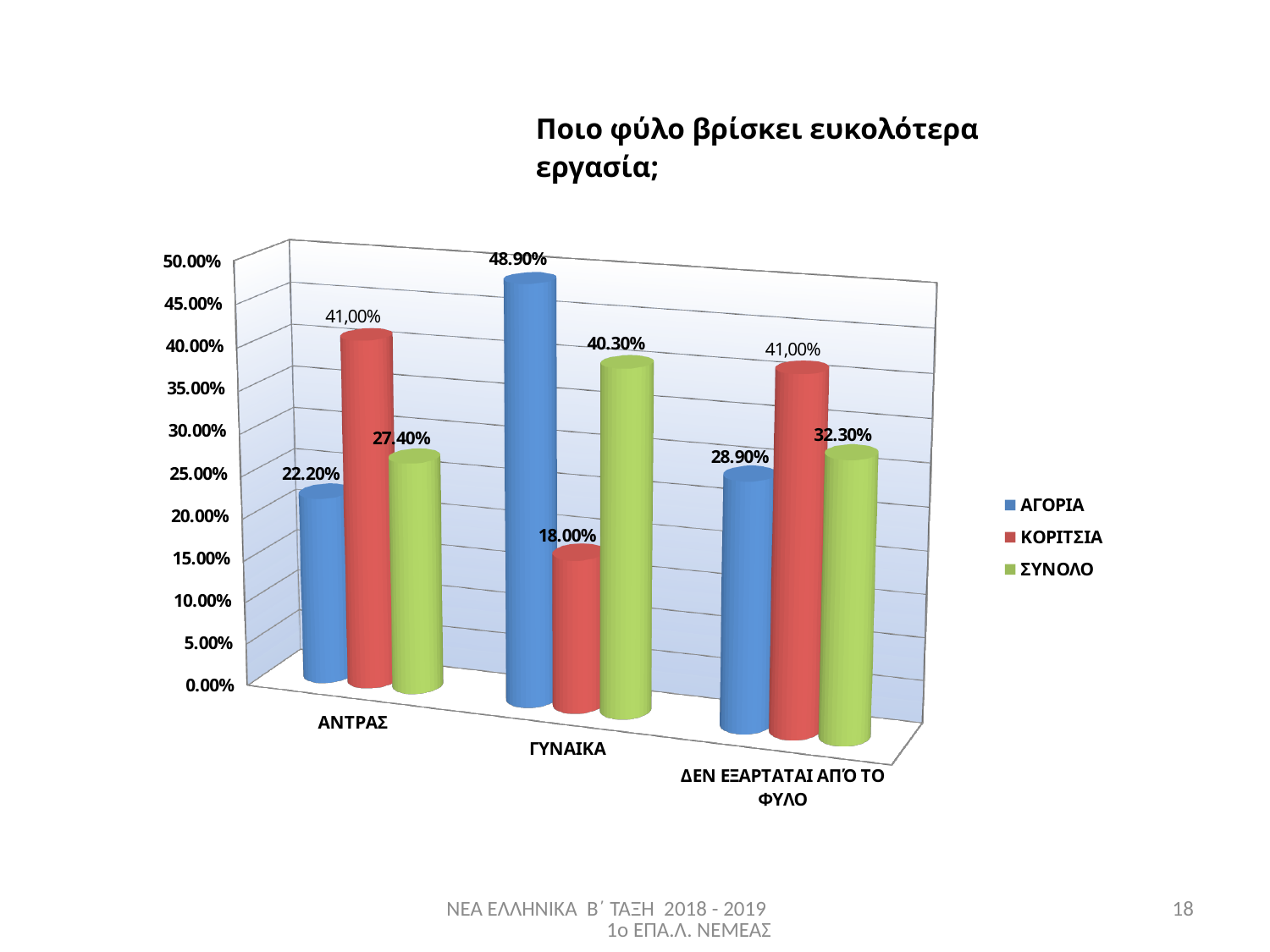
Which is larger in the ΔΕΝ ΕΞΑΡΤΑΤΑΙ ΑΠΌ ΤΟ ΦΥΛΟ category: ΑΓΟΡΙΑ or ΣΥΝΟΛΟ? ΣΥΝΟΛΟ How many series does the legend list? 3 What is the value for ΑΓΟΡΙΑ in the ΓΥΝΑΙΚΑ category? 48.90% What is the value for ΣΥΝΟΛΟ in the ΑΝΤΡΑΣ category? 27.40% What is the value for ΚΟΡΙΤΣΙΑ in the ΑΝΤΡΑΣ category? 41,00% In which category does the ΑΓΟΡΙΑ series have its highest value? ΓΥΝΑΙΚΑ What kind of chart is shown on the slide? Bar chart How many categories are shown on the x axis? 3 What is the value for ΣΥΝΟΛΟ in the ΔΕΝ ΕΞΑΡΤΑΤΑΙ ΑΠΌ ΤΟ ΦΥΛΟ category? 32.30% What is the difference between the ΑΓΟΡΙΑ values for ΓΥΝΑΙΚΑ and ΑΝΤΡΑΣ? 26.70% What is the value for ΚΟΡΙΤΣΙΑ in the ΓΥΝΑΙΚΑ category? 18.00% In which category does the ΚΟΡΙΤΣΙΑ series have its lowest value? ΓΥΝΑΙΚΑ